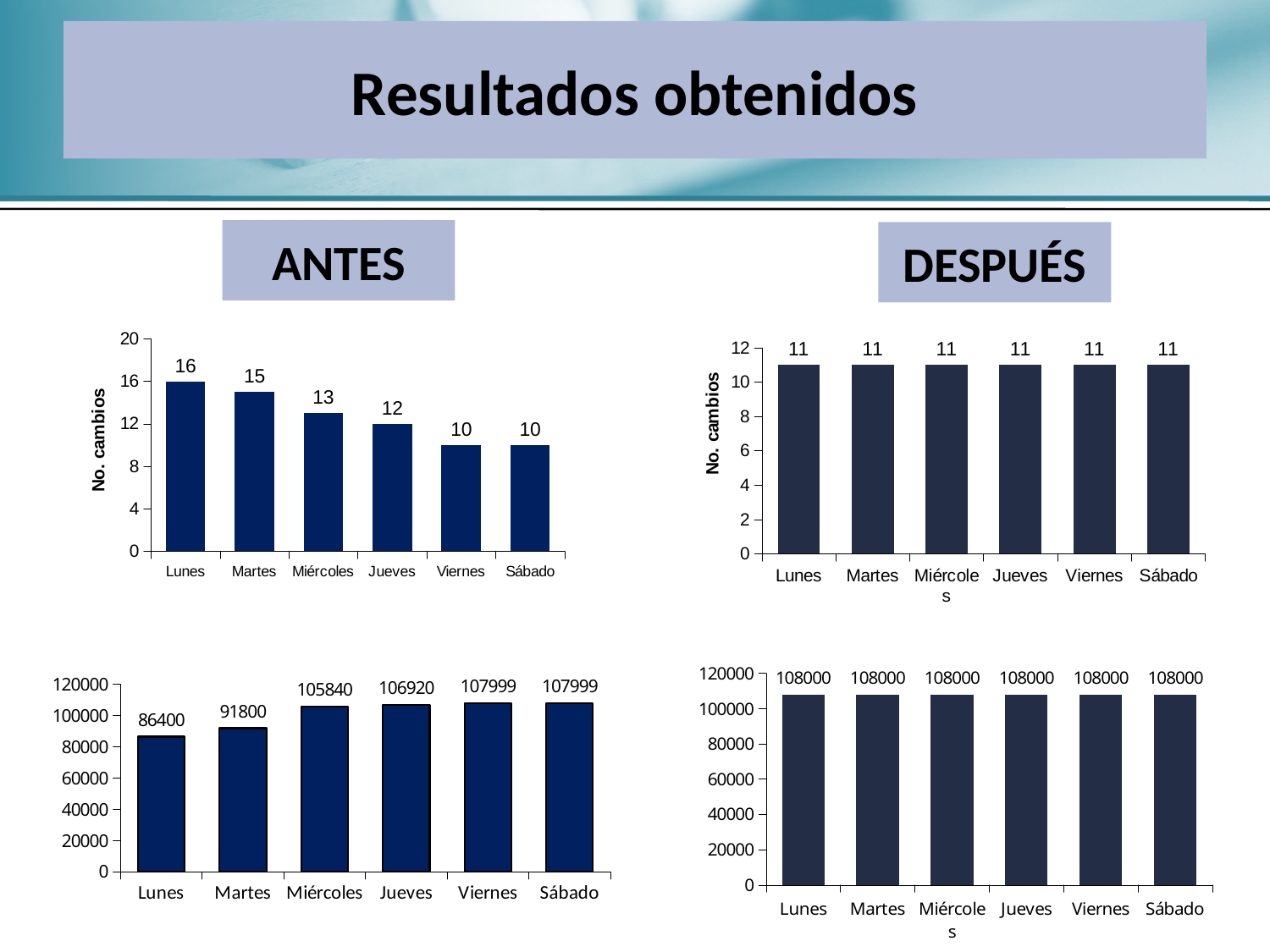
In the top-right chart under DESPUÉS, how many days are shown on the x axis? 6 In the bottom-left chart under ANTES, which day has the lowest value? Lunes In the bottom-left chart under ANTES, what is the value for Martes? 91800 In the top-left chart under ANTES, what is the difference between the values for Lunes and Jueves? 4 In the top-left chart under ANTES, do the values rise or fall from Lunes to Sábado? fall In the top-left chart under ANTES, what is the value for Lunes? 16 In the bottom-right chart under DESPUÉS, what is the value for Sábado? 108000 In the bottom-left chart under ANTES, what is the difference between the values for Miércoles and Lunes? 19440 In the top-right chart under DESPUÉS, what is the value for Miércoles? 11 What kind of chart is the bottom-right chart under DESPUÉS? bar chart In the bottom-left chart under ANTES, is the value for Jueves larger than the value for Martes? Yes In the top-left chart under ANTES, which day has the highest number of changes? Lunes